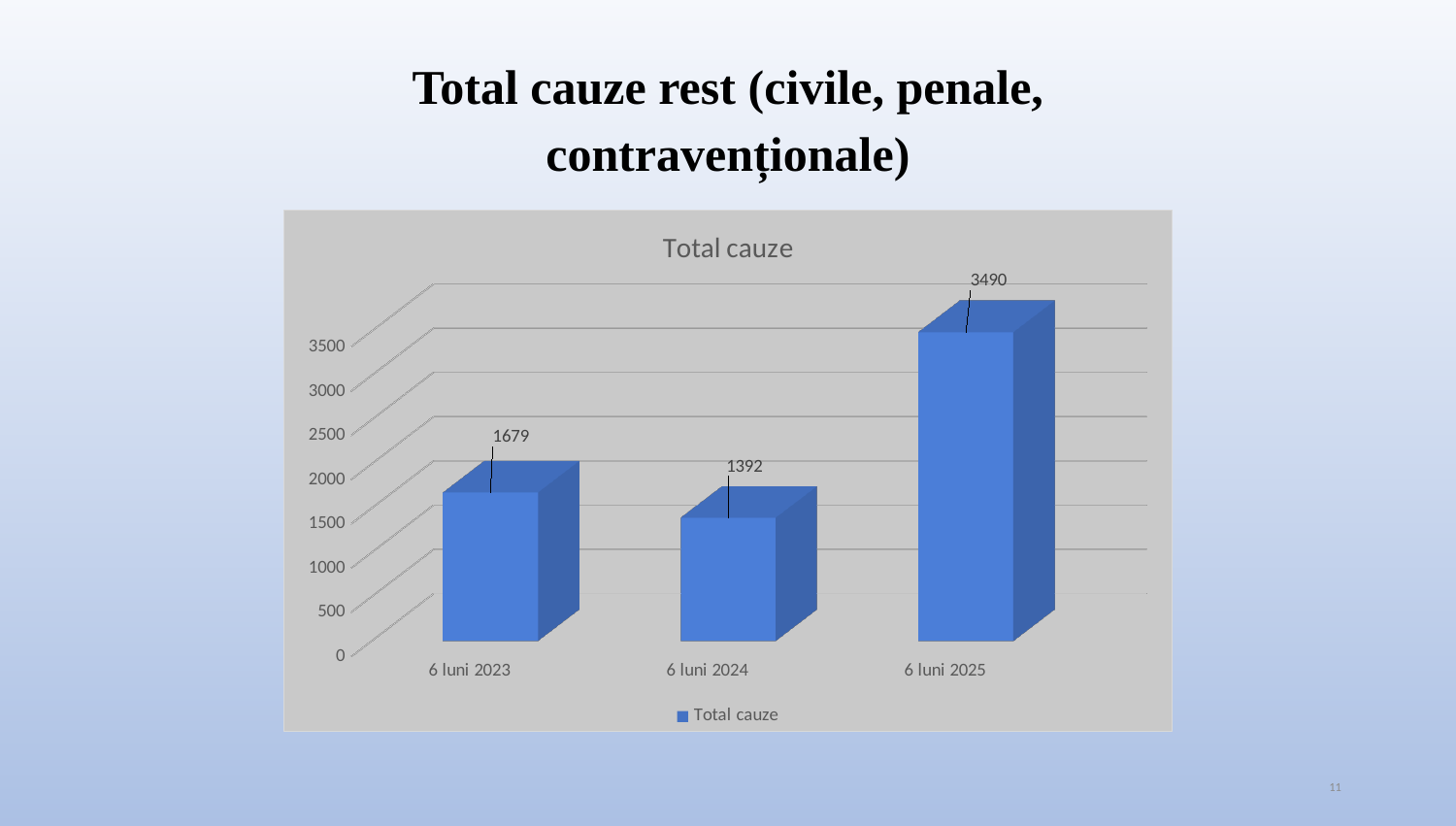
Is the value for 6 luni 2025 greater or less than 3000? greater What is the value for 6 luni 2023? 1679 Which category has the highest value? 6 luni 2025 What is the value for 6 luni 2025? 3490 What is the difference between the values for 6 luni 2025 and 6 luni 2024? 2098 What kind of chart is shown? bar chart How many categories are shown on the x axis? 3 What is the title of the chart? Total cauze Which is larger, the value for 6 luni 2023 or 6 luni 2024? 6 luni 2023 What is the value for 6 luni 2024? 1392 What is the difference between the values for 6 luni 2023 and 6 luni 2024? 287 Which category has the lowest value? 6 luni 2024